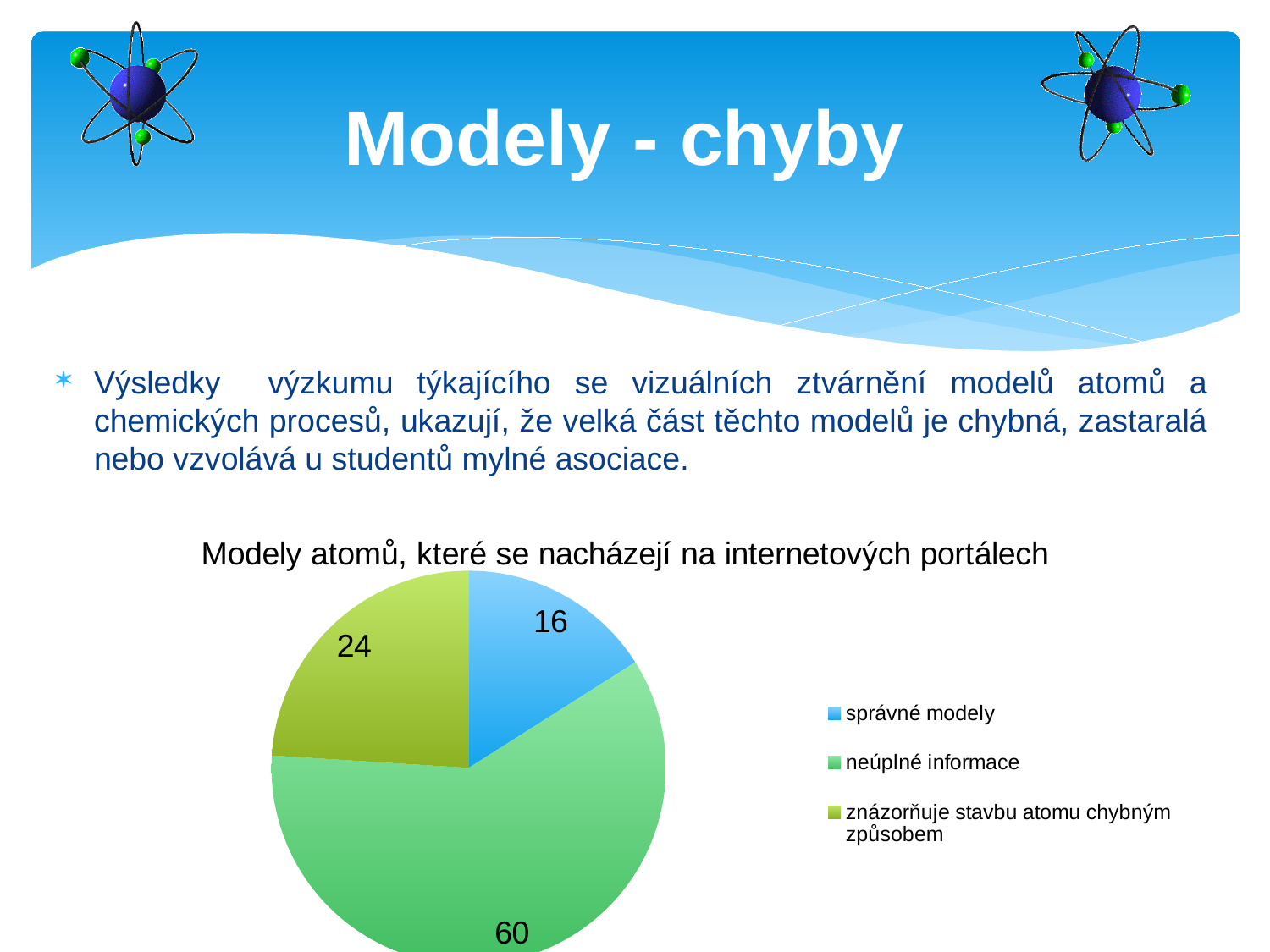
What is the value for 'správné modely'? 16 What type of chart is shown on the slide? pie chart Which category has the smallest slice? správné modely What is the value for 'znázorňuje stavbu atomu chybným způsobem'? 24 Which category has the largest slice? neúplné informace What is the value for 'neúplné informace'? 60 How many entries does the legend list? 3 What is the title of the chart? Modely atomů, které se nacházejí na internetových portálech What is the difference between the values for 'neúplné informace' and 'správné modely'? 44 How many slices does the pie chart have? 3 What share of the pie does 'neúplné informace' represent? 60% Which is larger, the value for 'znázorňuje stavbu atomu chybným způsobem' or the value for 'správné modely'? znázorňuje stavbu atomu chybným způsobem